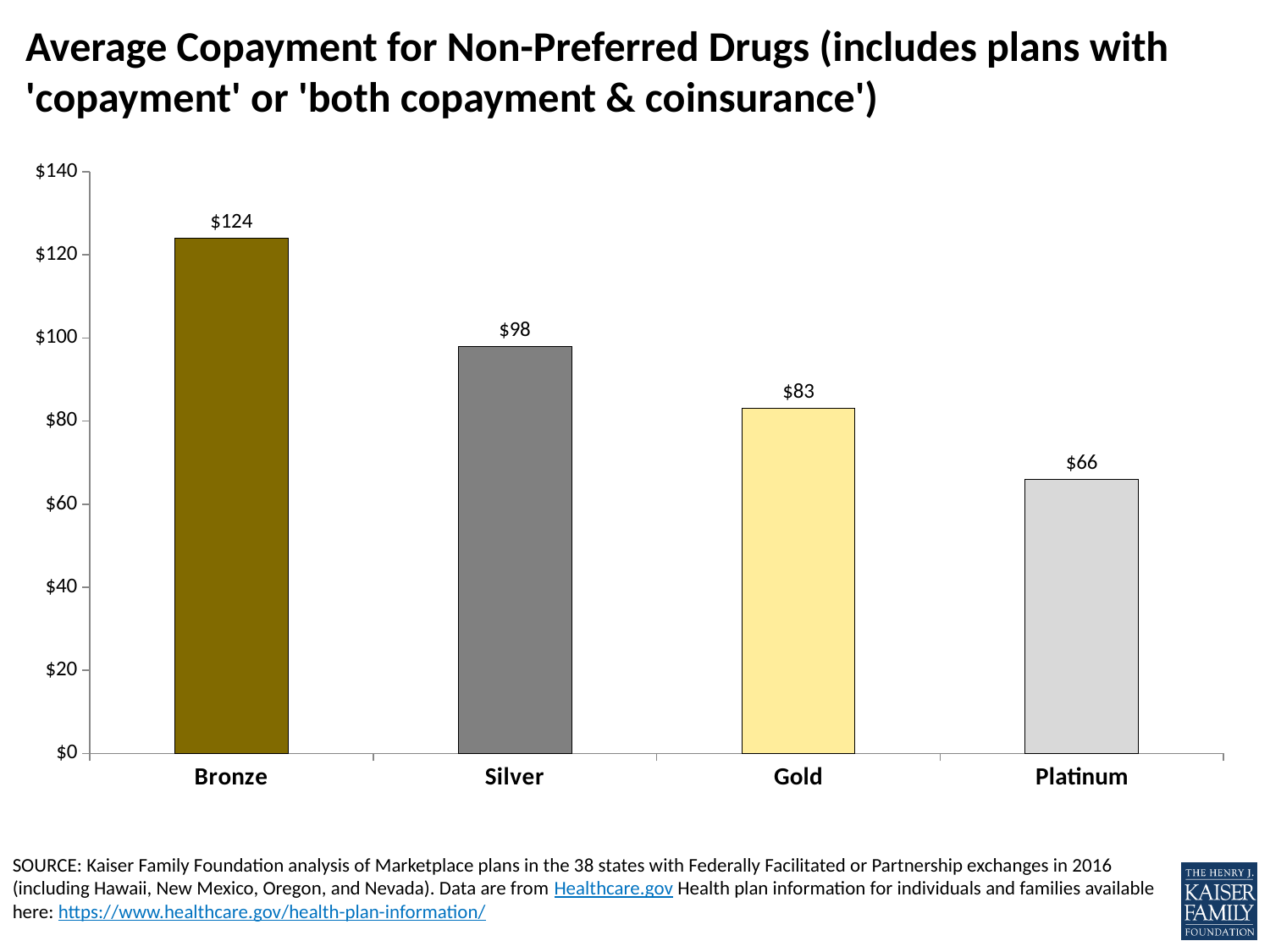
What is the difference between the average copayment for Silver and Gold plans? $15 What is the average copayment for non-preferred drugs for Platinum plans? $66 What is the average copayment for non-preferred drugs for Silver plans? $98 What is the average copayment for non-preferred drugs for Gold plans? $83 Which plan type has the highest average copayment for non-preferred drugs? Bronze How much higher is the average copayment for Bronze plans than for Platinum plans? $58 Is the average copayment for Gold plans greater or less than $100? less How many plan types are shown in the chart? 4 Which has a larger average copayment for non-preferred drugs, Silver or Gold? Silver What kind of chart is used on this slide? Bar chart What is the average copayment for non-preferred drugs for Bronze plans? $124 Which plan type has the lowest average copayment for non-preferred drugs? Platinum